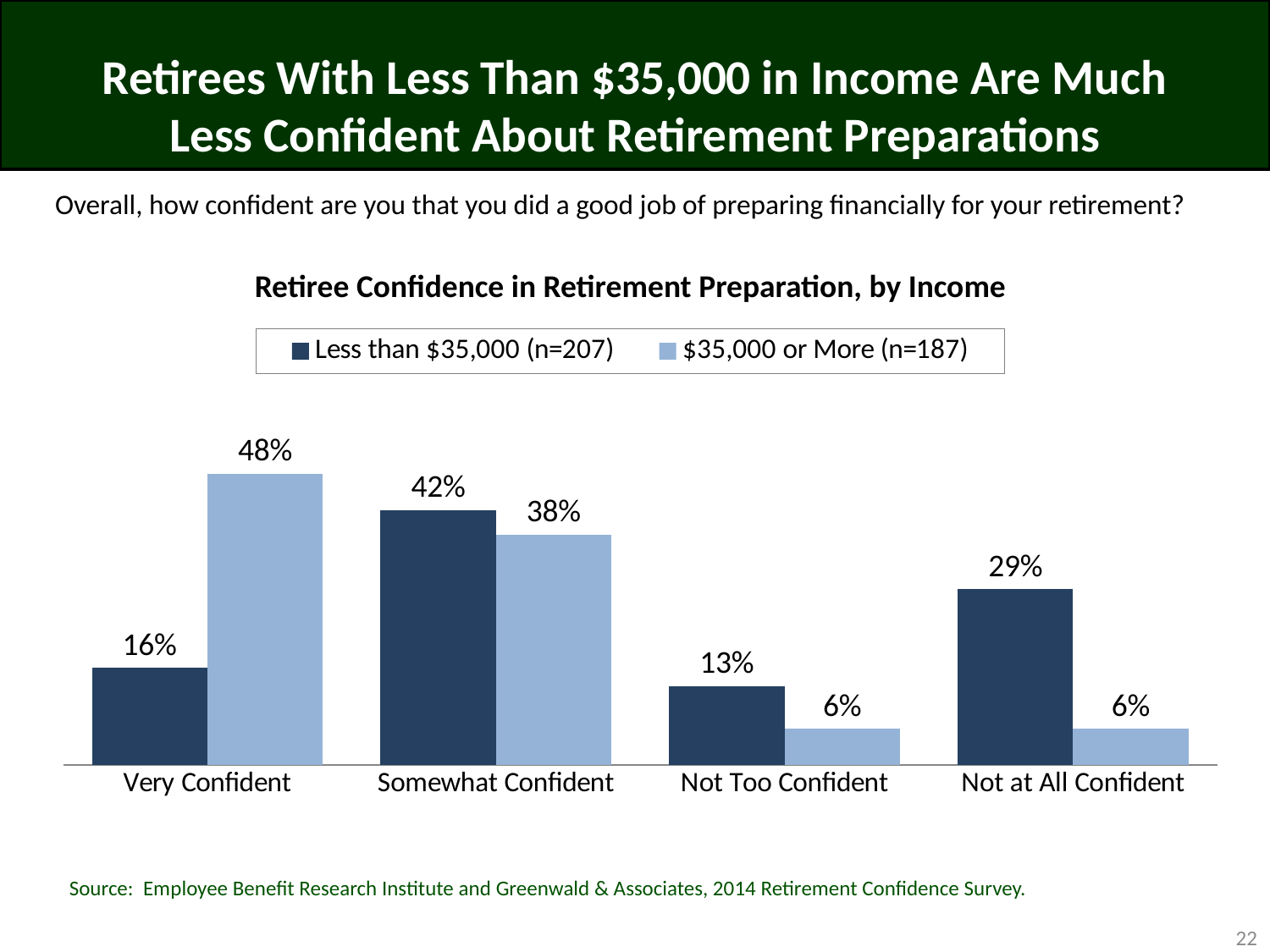
How many series does the legend list? 2 What is the difference between the two income groups for Not at All Confident? 23 percentage points What percentage of retirees with $35,000 or more in income are Not Too Confident? 6% What kind of chart is shown on the slide? Bar chart What is the difference between the two income groups for Very Confident? 32 percentage points Which confidence category has the highest value for the Less than $35,000 group? Somewhat Confident What percentage of retirees with less than $35,000 in income are Very Confident? 16% What percentage of retirees with less than $35,000 in income are Not at All Confident? 29% For Somewhat Confident, which income group has the larger value? Less than $35,000 How many confidence categories are shown on the x axis? 4 What percentage of retirees with $35,000 or more in income are Very Confident? 48% Which confidence category has the highest value for the $35,000 or More group? Very Confident